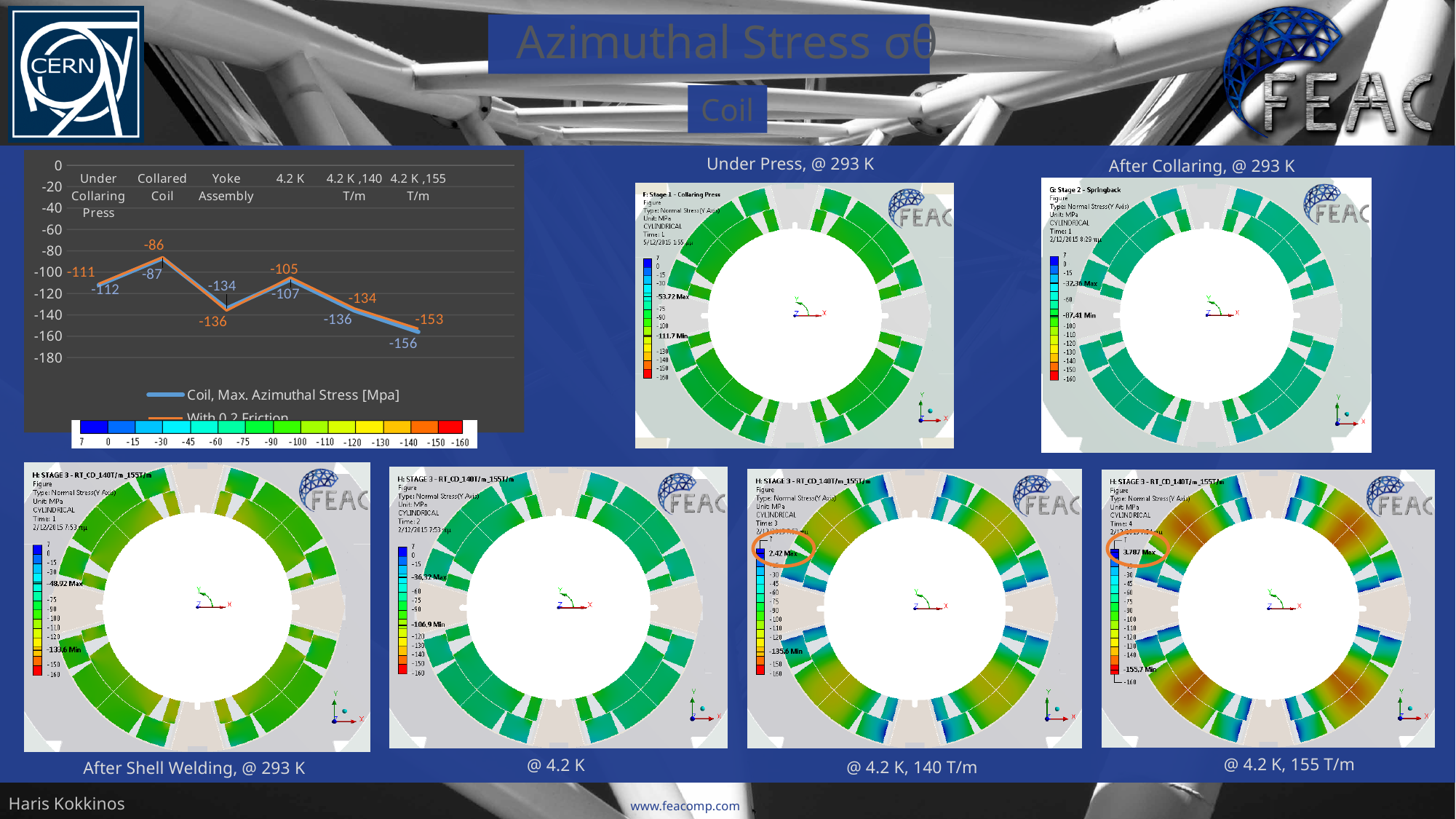
Which category has the highest With 0.2 Friction value? Collared Coil What is the Coil, Max. Azimuthal Stress [Mpa] value at 4.2 K, 155 T/m? -156 How many categories are plotted along the x axis of the line chart? 6 What is the Coil, Max. Azimuthal Stress [Mpa] value for Collared Coil? -87 Which is larger, the Coil, Max. Azimuthal Stress [Mpa] value at 4.2 K or at Yoke Assembly? 4.2 K What is the difference between the Coil, Max. Azimuthal Stress [Mpa] values at Under Collaring Press and at 4.2 K, 155 T/m? 44 How many series does the legend of the line chart list? 2 What is the With 0.2 Friction value at 4.2 K? -105 What type of chart is shown on the left of the slide? line chart Which category has the lowest Coil, Max. Azimuthal Stress [Mpa] value? 4.2 K, 155 T/m What is the With 0.2 Friction value for Yoke Assembly? -136 Do the Coil, Max. Azimuthal Stress [Mpa] values rise or fall from 4.2 K to 4.2 K, 155 T/m? fall